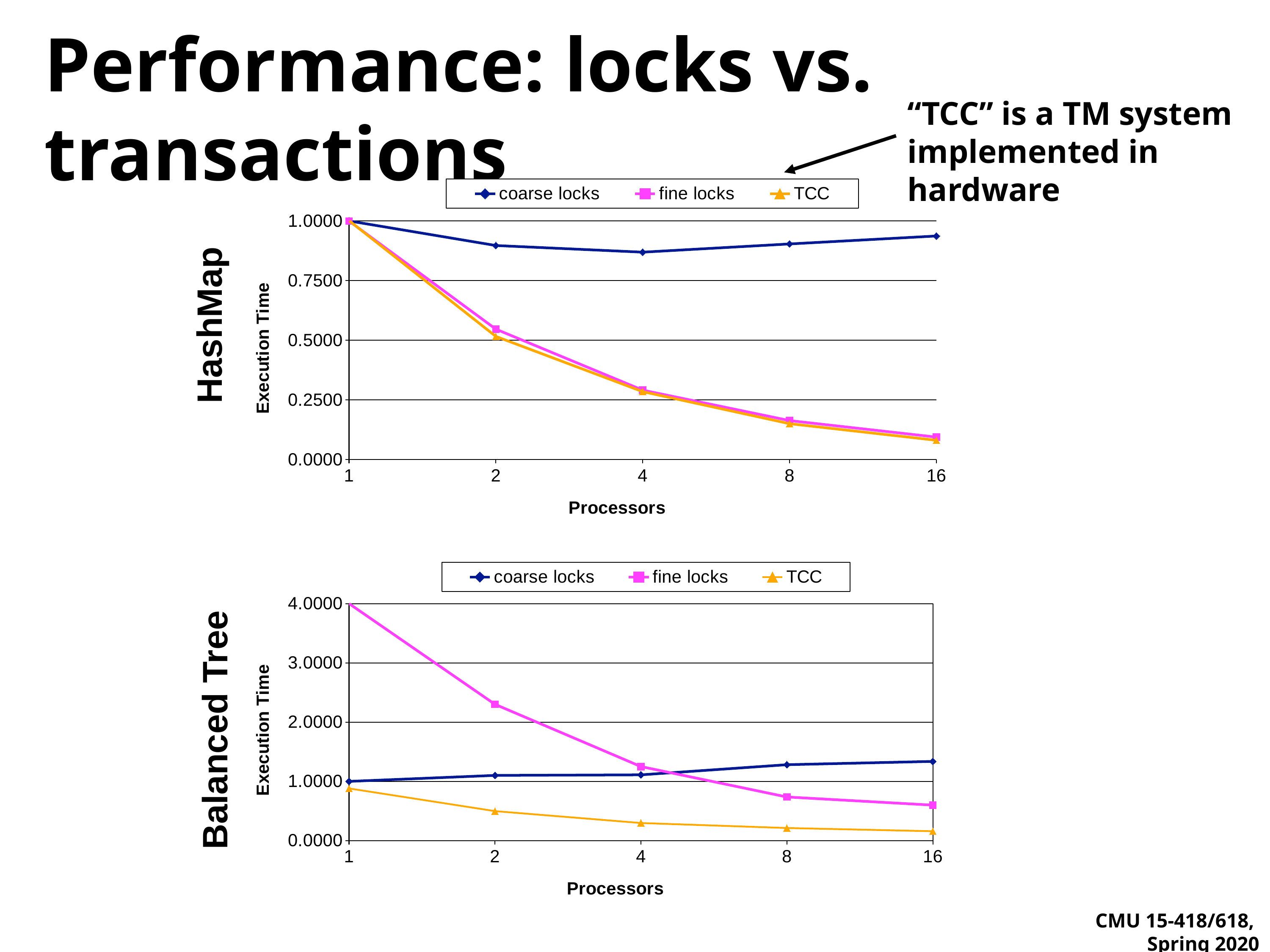
How many series does the legend of the Balanced Tree chart list? 3 In the Balanced Tree chart, which series has the lowest execution time at 16 processors? TCC In the HashMap chart, is the value for coarse locks at 16 processors greater or less than 0.7500? greater In the HashMap chart, which series has the highest execution time at 4 processors? coarse locks In the Balanced Tree chart, is the value for fine locks at 2 processors greater or less than 2.0000? greater How many processor counts are plotted along the x axis of the HashMap chart? 5 In the Balanced Tree chart, is the value for TCC at 4 processors greater or less than 1.0000? less In the Balanced Tree chart, does the execution time for fine locks rise or fall as the number of processors increases? fall What type of chart is the HashMap chart? line chart